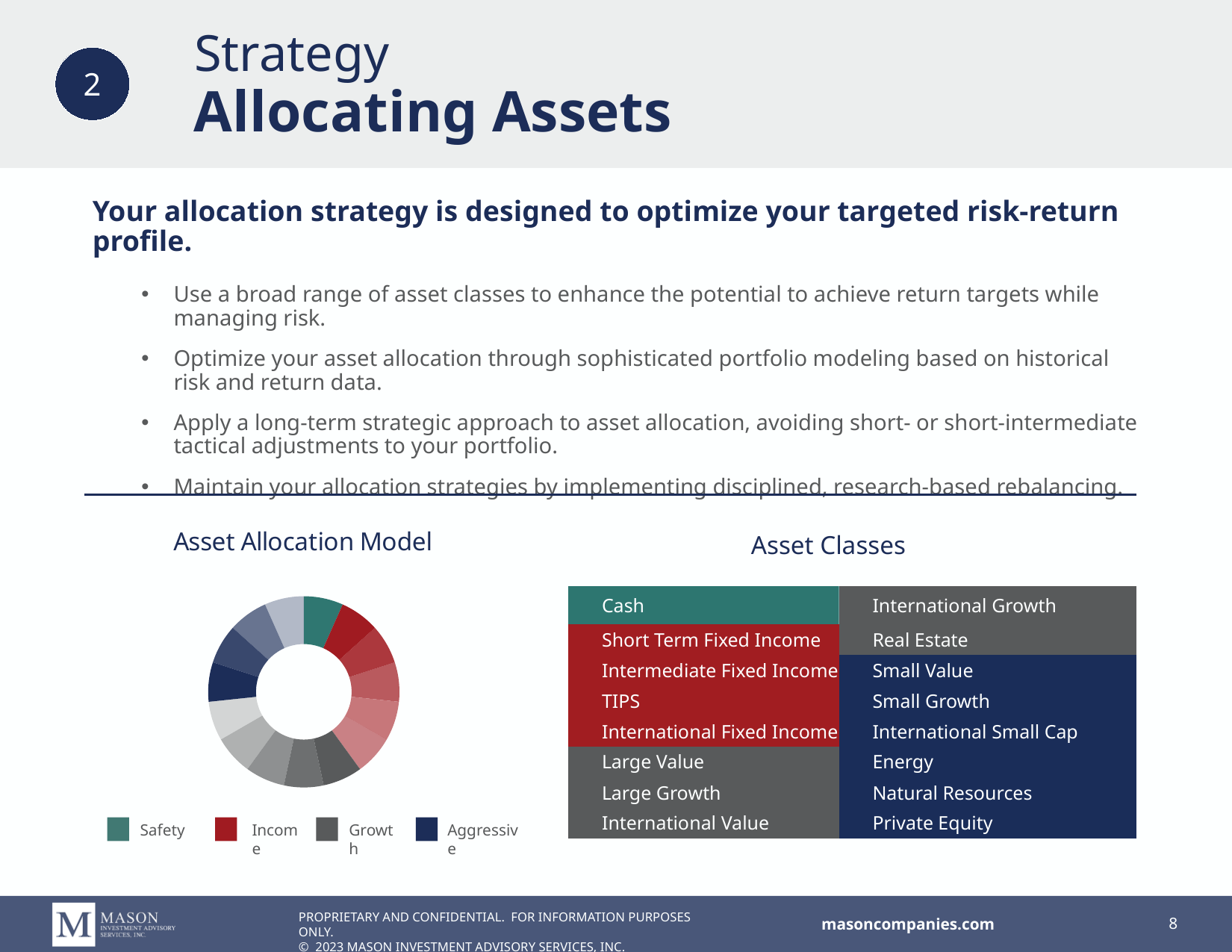
In the Asset Allocation Model chart, which takes up a larger share of the ring, Aggressive or Safety? Aggressive Which legend entries are shown for the Asset Allocation Model chart? Safety, Income, Growth, Aggressive What kind of chart is shown under the title "Asset Allocation Model"? Pie chart (donut) What is the title of the chart on the left of the slide? Asset Allocation Model Does the Asset Allocation Model chart print percentage values on its slices? No In the Asset Allocation Model chart, which takes up a larger share of the ring, Safety or Income? Income How many entries does the legend of the Asset Allocation Model chart list? 4 In the Asset Allocation Model chart, which legend category takes up the smallest share of the ring? Safety